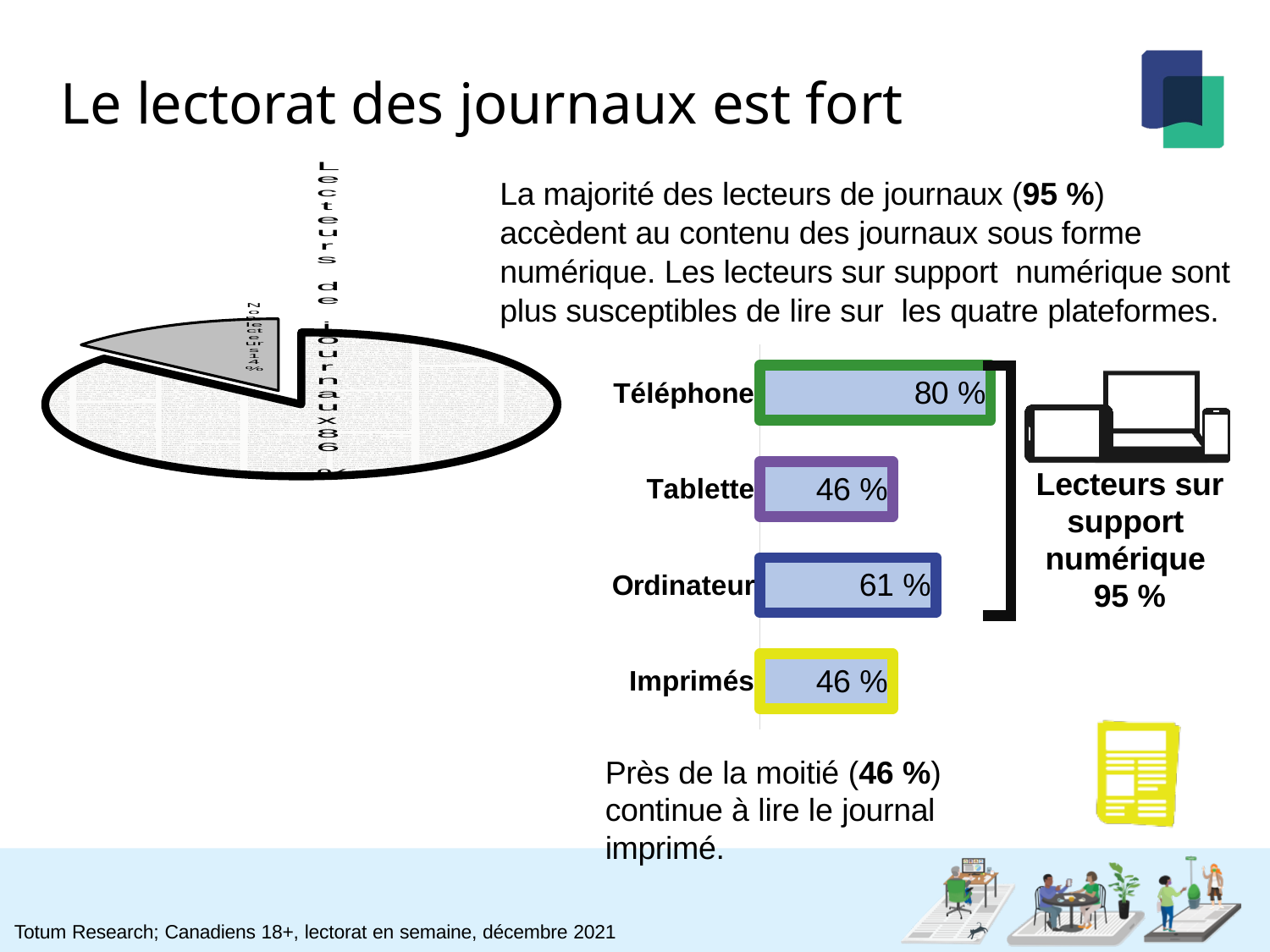
In the bar chart, which is larger, the value for Ordinateur or the value for Tablette? Ordinateur What kind of chart is the chart on the right of the slide? Bar chart In the bar chart, which category has the highest value? Téléphone In the bar chart, what is the value for Tablette? 46 % In the bar chart, what colour is the border of the Téléphone bar? Green In the bar chart, what is the value for Téléphone? 80 % What kind of chart is the chart on the left of the slide? Pie chart In the bar chart, what is the difference between the values for Téléphone and Ordinateur? 19 % How many categories does the bar chart on the right show? 4 In the bar chart, what is the difference between the values for Ordinateur and Imprimés? 15 % In the bar chart, what is the value for Ordinateur? 61 % In the bar chart, what is the value for Imprimés? 46 %